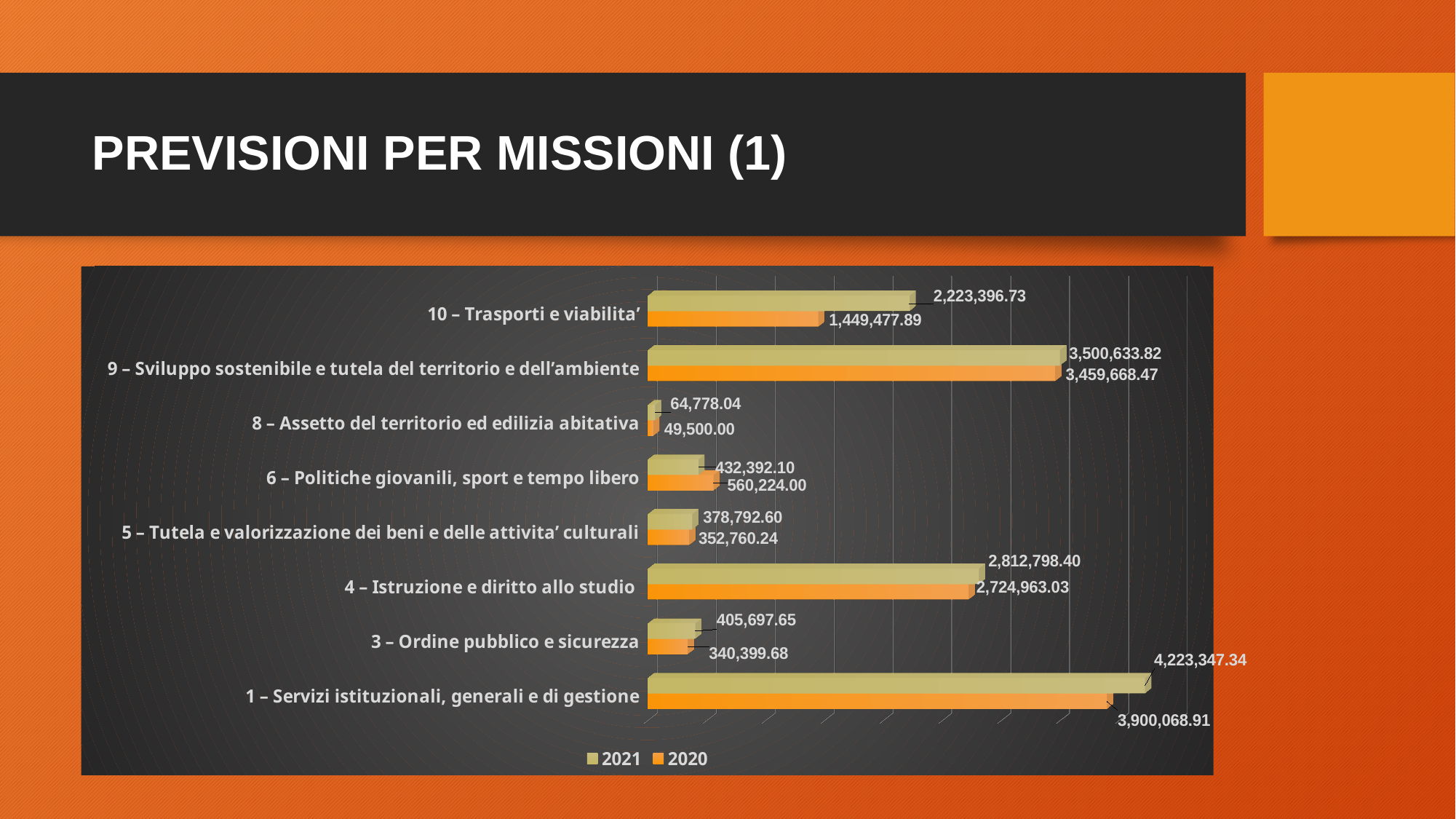
What is the 2020 value for '8 – Assetto del territorio ed edilizia abitativa'? 49,500.00 What is the 2021 value for '3 – Ordine pubblico e sicurezza'? 405,697.65 For '6 – Politiche giovanili, sport e tempo libero', which year has the larger value, 2021 or 2020? 2020 Which category has the lowest 2020 value? 8 – Assetto del territorio ed edilizia abitativa What is the 2020 value for '4 – Istruzione e diritto allo studio'? 2,724,963.03 How many series does the legend list? 2 What is the difference between the 2021 and 2020 values for '10 – Trasporti e viabilita''? 773,918.84 How many categories (missioni) are shown in the chart? 8 What is the 2021 value for '10 – Trasporti e viabilita''? 2,223,396.73 What kind of chart is shown on the slide? Bar chart Which category has the highest 2021 value? 1 – Servizi istituzionali, generali e di gestione What is the difference between the 2020 and 2021 values for '6 – Politiche giovanili, sport e tempo libero'? 127,831.90